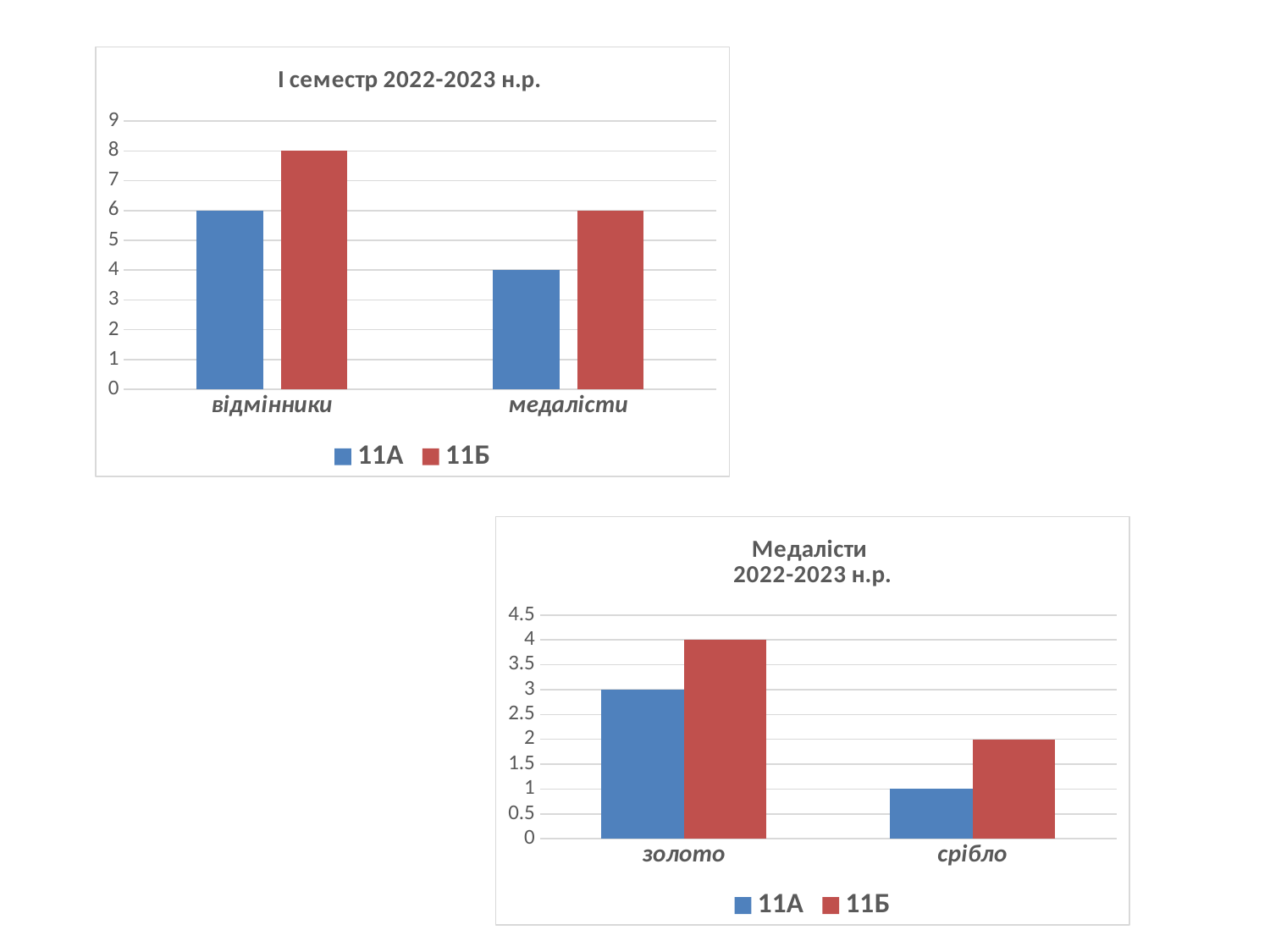
In the chart titled "І семестр 2022-2023 н.р.", how many series does the legend list? 2 In the chart titled "Медалісти 2022-2023 н.р.", what is the difference between 11Б and 11А in the срібло category? 1 In the chart titled "Медалісти 2022-2023 н.р.", which category has the lowest value for 11А? срібло In the chart titled "І семестр 2022-2023 н.р.", what is the value for 11Б in the відмінники category? 8 In the chart titled "Медалісти 2022-2023 н.р.", what is the value for 11А in the срібло category? 1 In the chart titled "І семестр 2022-2023 н.р.", which series has the higher value for медалісти, 11А or 11Б? 11Б In the chart titled "Медалісти 2022-2023 н.р.", what colour are the bars for 11Б? red In the chart titled "Медалісти 2022-2023 н.р.", what is the value for 11Б in the золото category? 4 In the chart titled "І семестр 2022-2023 н.р.", what is the value for 11А in the медалісти category? 4 In the chart titled "Медалісти 2022-2023 н.р.", how many categories are shown on the x axis? 2 What kind of chart is the chart titled "І семестр 2022-2023 н.р."? bar chart In the chart titled "І семестр 2022-2023 н.р.", what is the difference between 11Б and 11А in the відмінники category? 2